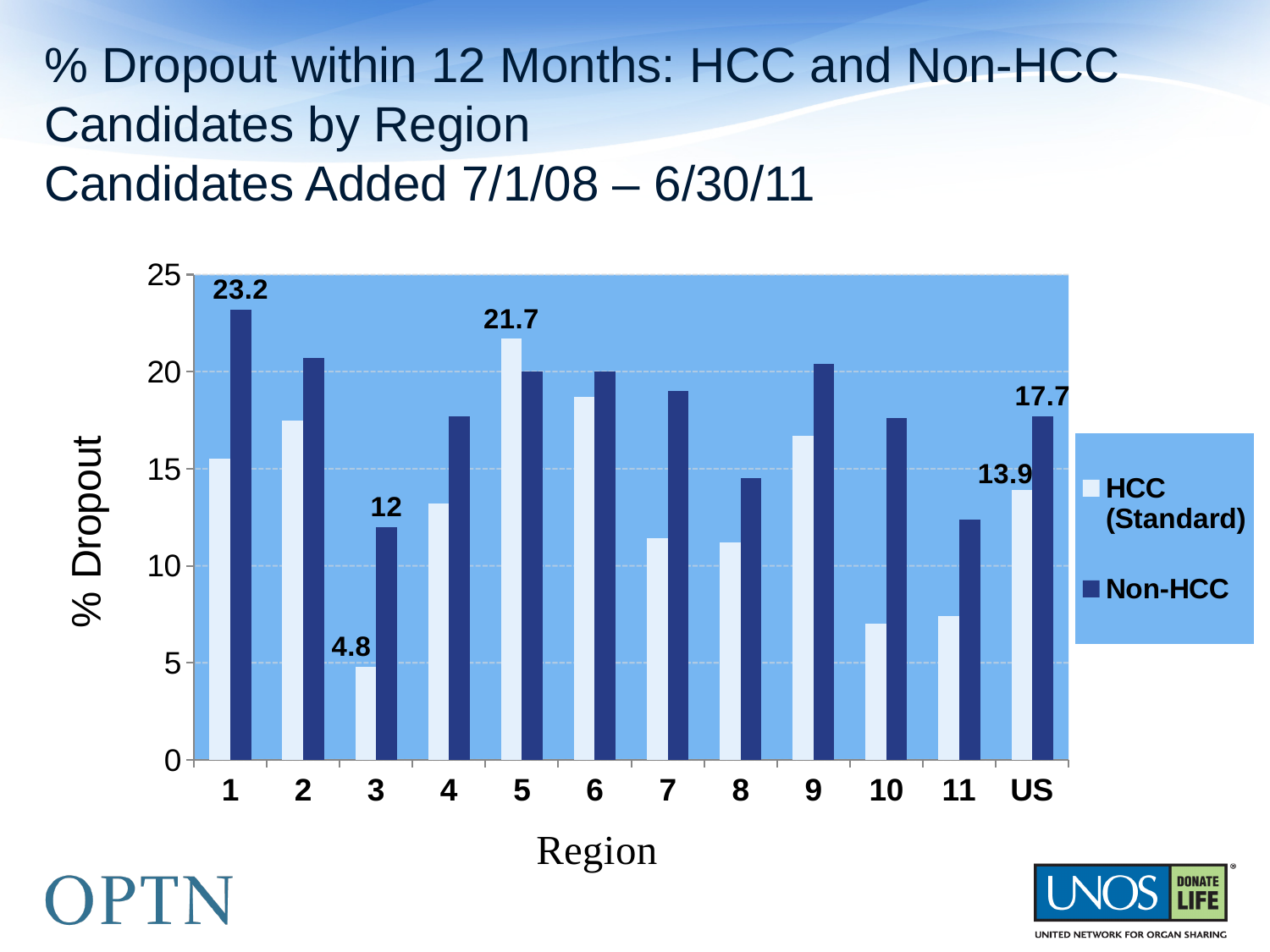
For the US overall, how much higher is the Non-HCC % dropout than the HCC (Standard) % dropout? 3.8 Is the % dropout for HCC (Standard) candidates in Region 10 greater or less than 10? less Which region has the lowest % dropout for HCC (Standard) candidates? Region 3 Which region has the highest % dropout for Non-HCC candidates? Region 1 What is the % dropout for HCC (Standard) candidates for the US overall? 13.9 How many series does the legend list? 2 What is the % dropout for HCC (Standard) candidates in Region 5? 21.7 What is the % dropout for Non-HCC candidates in Region 3? 12 What is the % dropout for HCC (Standard) candidates in Region 3? 4.8 What is the % dropout for Non-HCC candidates for the US overall? 17.7 In Region 3, which group has the higher % dropout, HCC (Standard) or Non-HCC? Non-HCC What is the % dropout for Non-HCC candidates in Region 1? 23.2